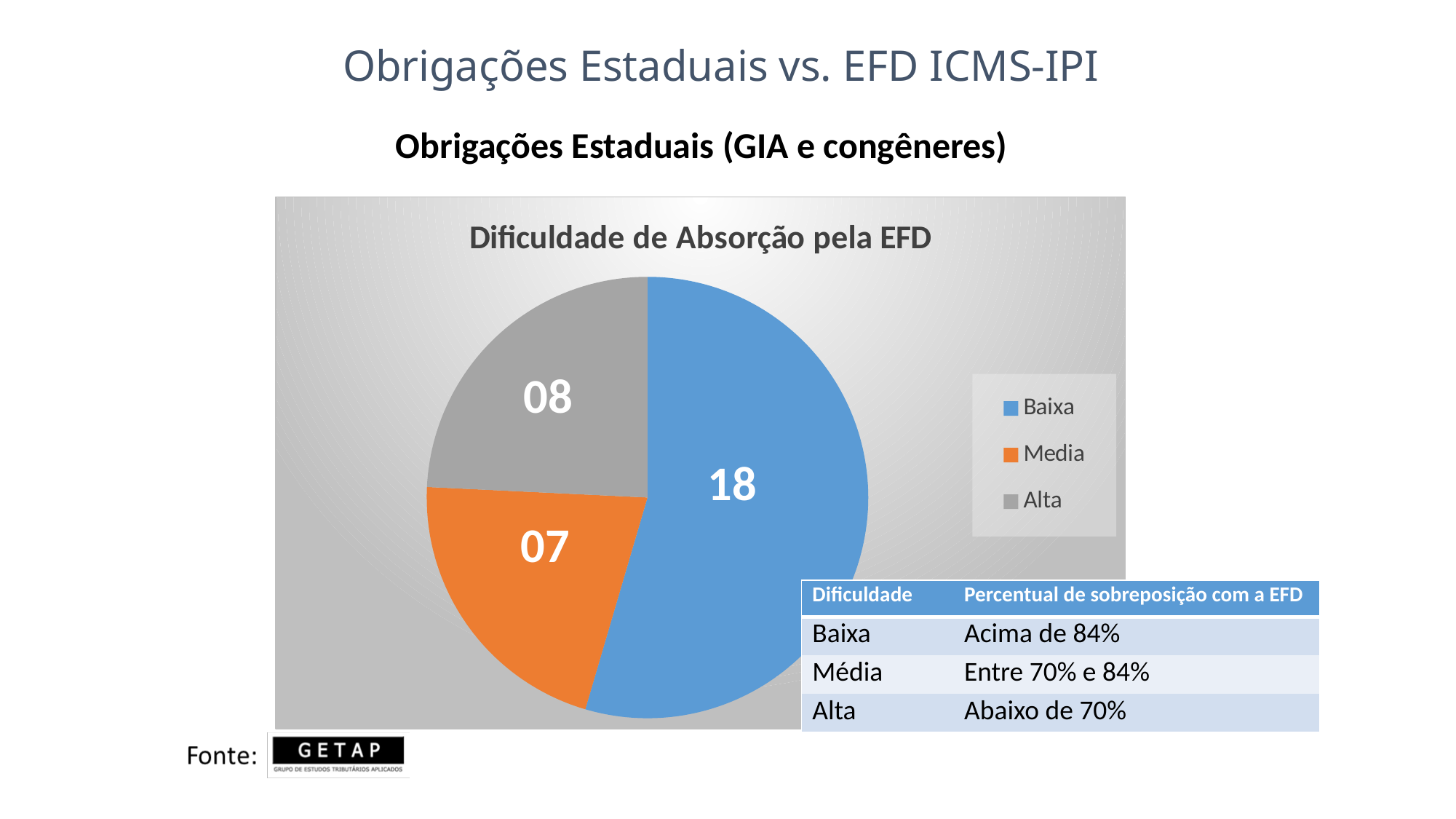
What is the title of the chart? Dificuldade de Absorção pela EFD What type of chart is shown on the slide? pie chart What is the difference between the Baixa value and the Alta value? 10 What is the value of the Alta slice? 08 Which category has the largest slice of the pie? Baixa Which is larger, the Alta slice or the Media slice? Alta How many entries does the legend list? 3 What is the value of the Baixa slice? 18 What is the value of the Media slice? 07 What is the total of all the slice values in the pie chart? 33 Which category has the smallest slice of the pie? Media How many slices does the pie chart have? 3